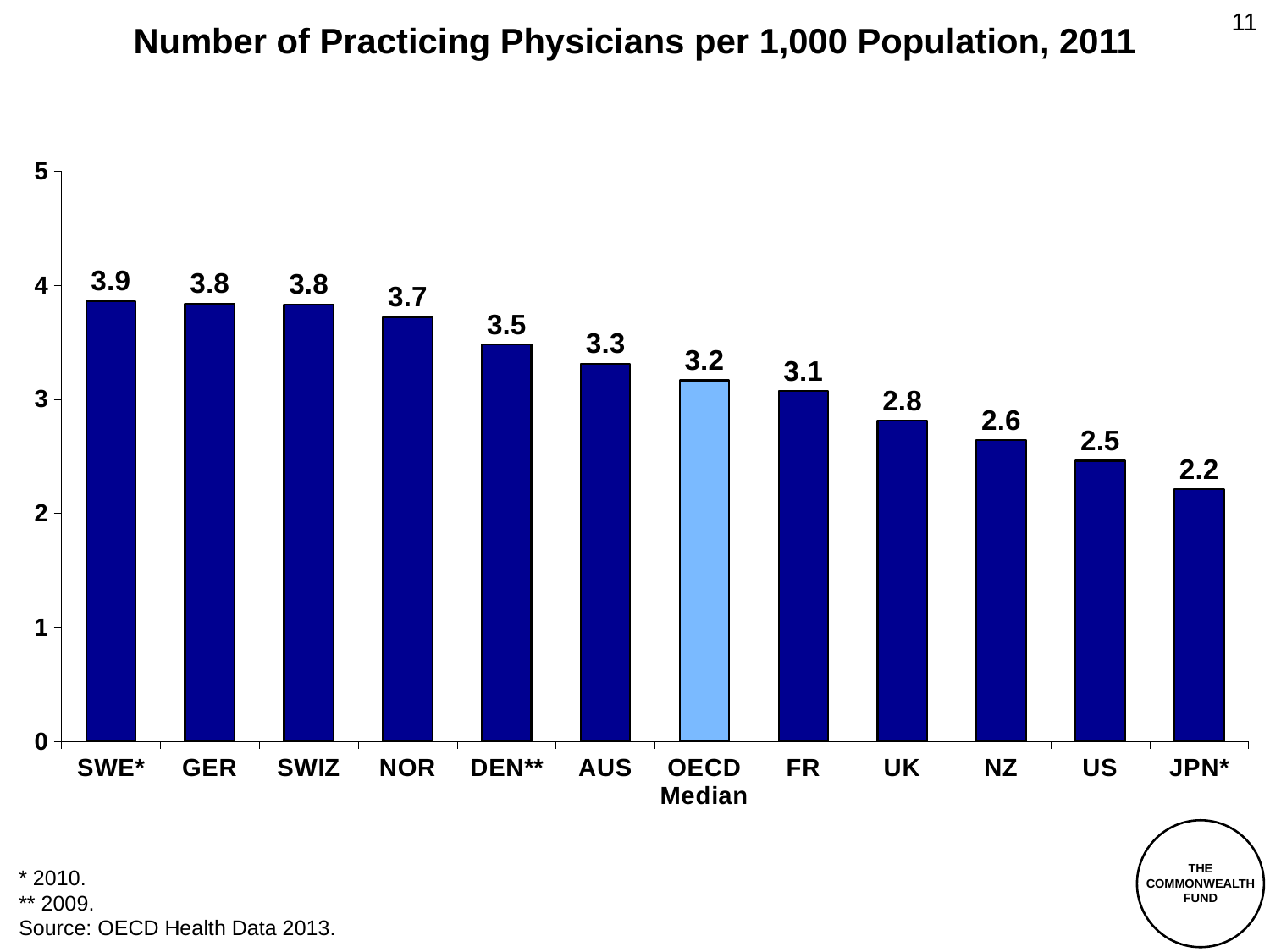
How many bars are shown in the chart? 12 What is the difference between the values for the OECD Median and the US? 0.7 Which bar is shown in a lighter blue colour than the others? OECD Median What is the value shown for the OECD Median? 3.2 What type of chart is shown on the slide? Bar chart Is the value for DEN** greater or less than 3? greater What is the number of practicing physicians per 1,000 population for the US? 2.5 What is the difference between the values for SWE* and JPN*? 1.7 Which country has the highest number of practicing physicians per 1,000 population? SWE* Which country has the lowest number of practicing physicians per 1,000 population? JPN* Which has a higher value, UK or NZ? UK What is the value shown for NOR? 3.7